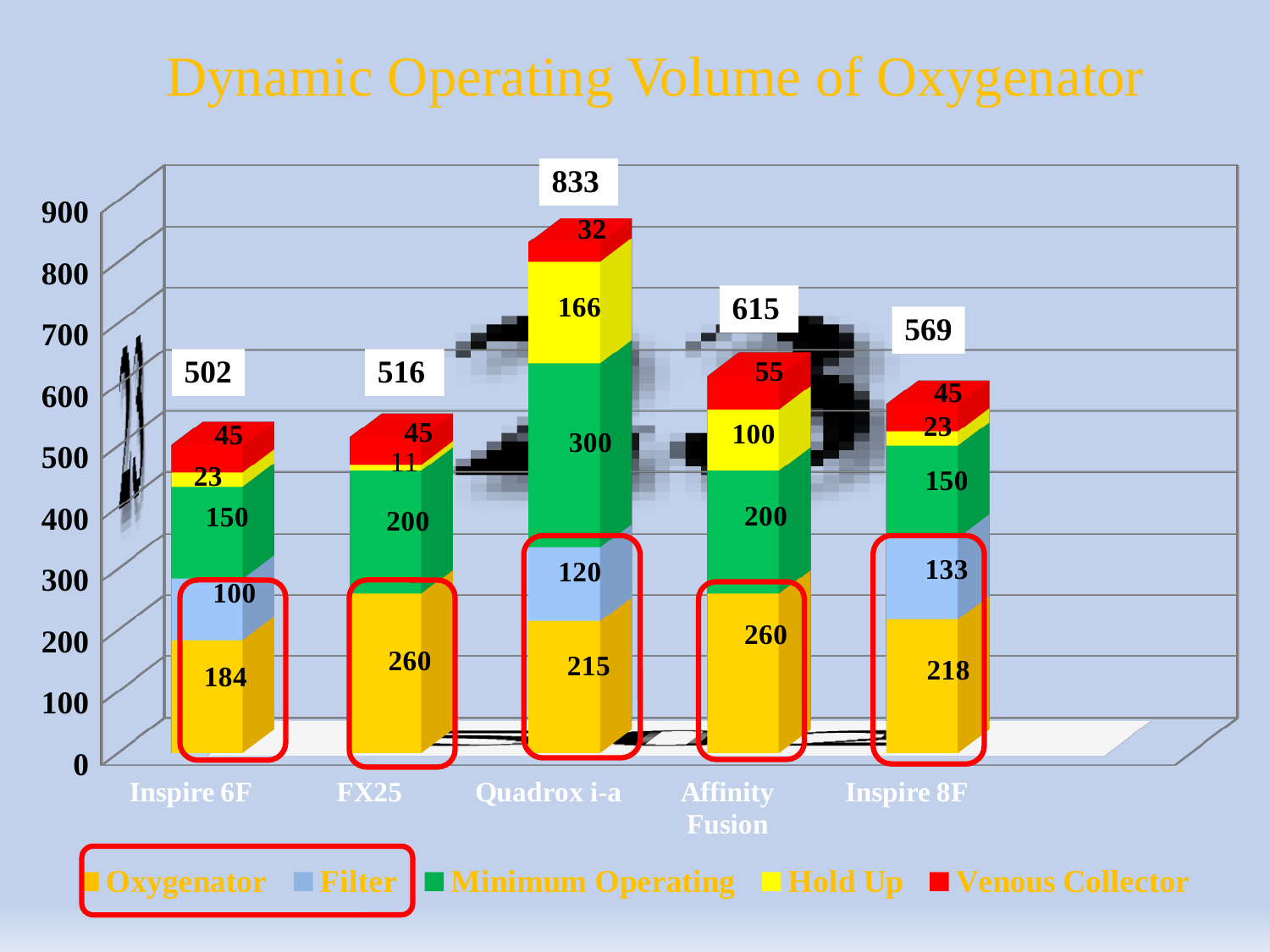
What is the title of the chart? Dynamic Operating Volume of Oxygenator What is the Filter value for Inspire 8F? 133 Which oxygenator has the highest total dynamic operating volume? Quadrox i-a What type of chart is shown on the slide? Stacked bar chart Which is larger, the Minimum Operating value for FX25 or for Inspire 6F? FX25 What is the total dynamic operating volume shown for Quadrox i-a? 833 What is the Hold Up value for Affinity Fusion? 100 What is the Oxygenator value for Inspire 6F? 184 Which oxygenator has the lowest total dynamic operating volume? Inspire 6F What is the difference between the total for Affinity Fusion and the total for Inspire 8F? 46 How many oxygenators are shown on the x axis? 5 How many series does the legend list? 5